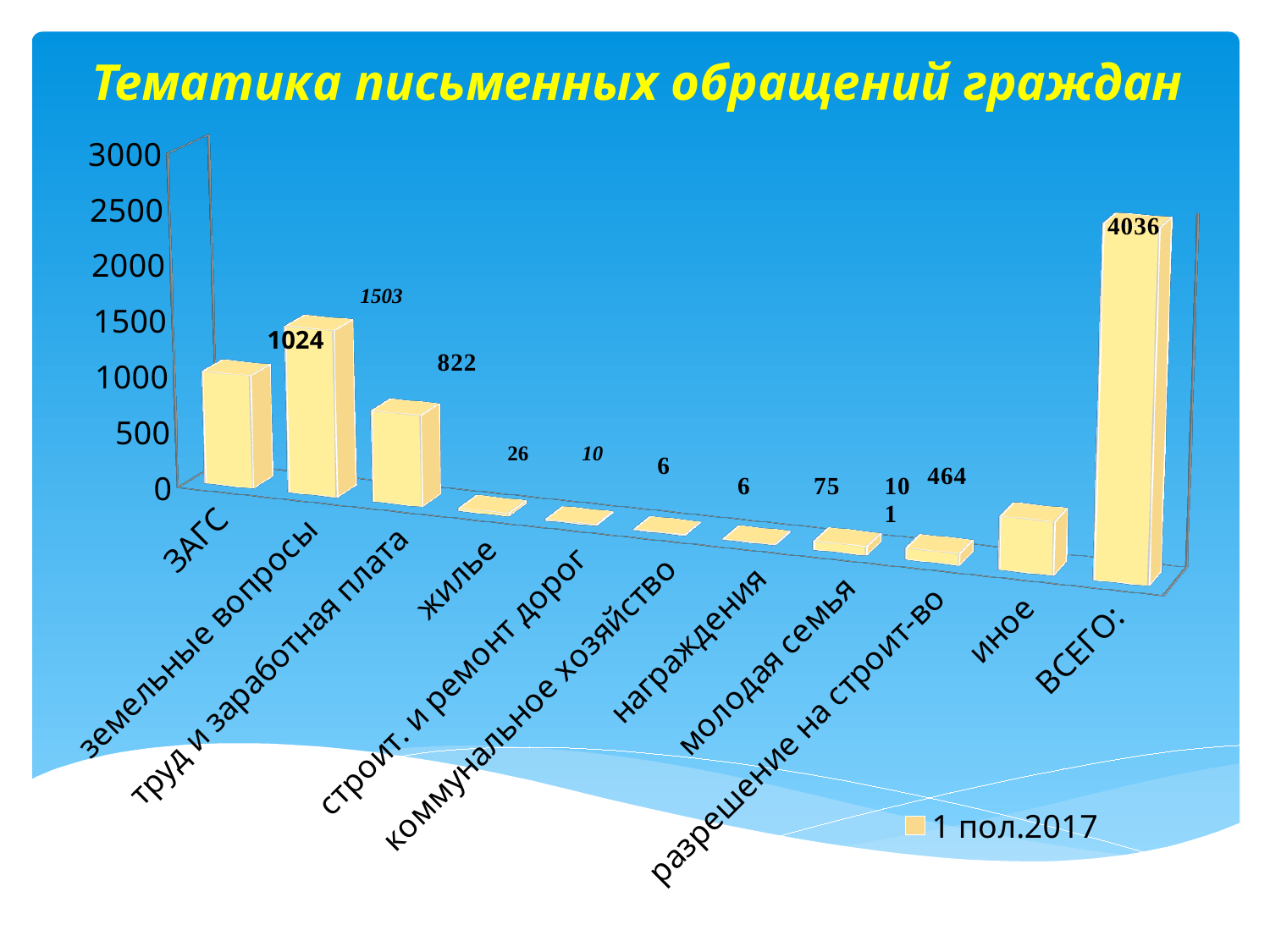
What is the difference between земельные вопросы and ЗАГС? 479 What is the value for иное? 464 How many categories are shown on the x axis? 11 Is the value for труд и заработная плата greater or less than 1000? less Which category has the highest value? ВСЕГО: What is the value for труд и заработная плата? 822 Which is larger, the value for жилье or the value for иное? иное What is the value for ЗАГС? 1024 What is the value for земельные вопросы? 1503 How many series does the legend list? 1 What is the value for молодая семья? 75 What type of chart is shown? bar chart